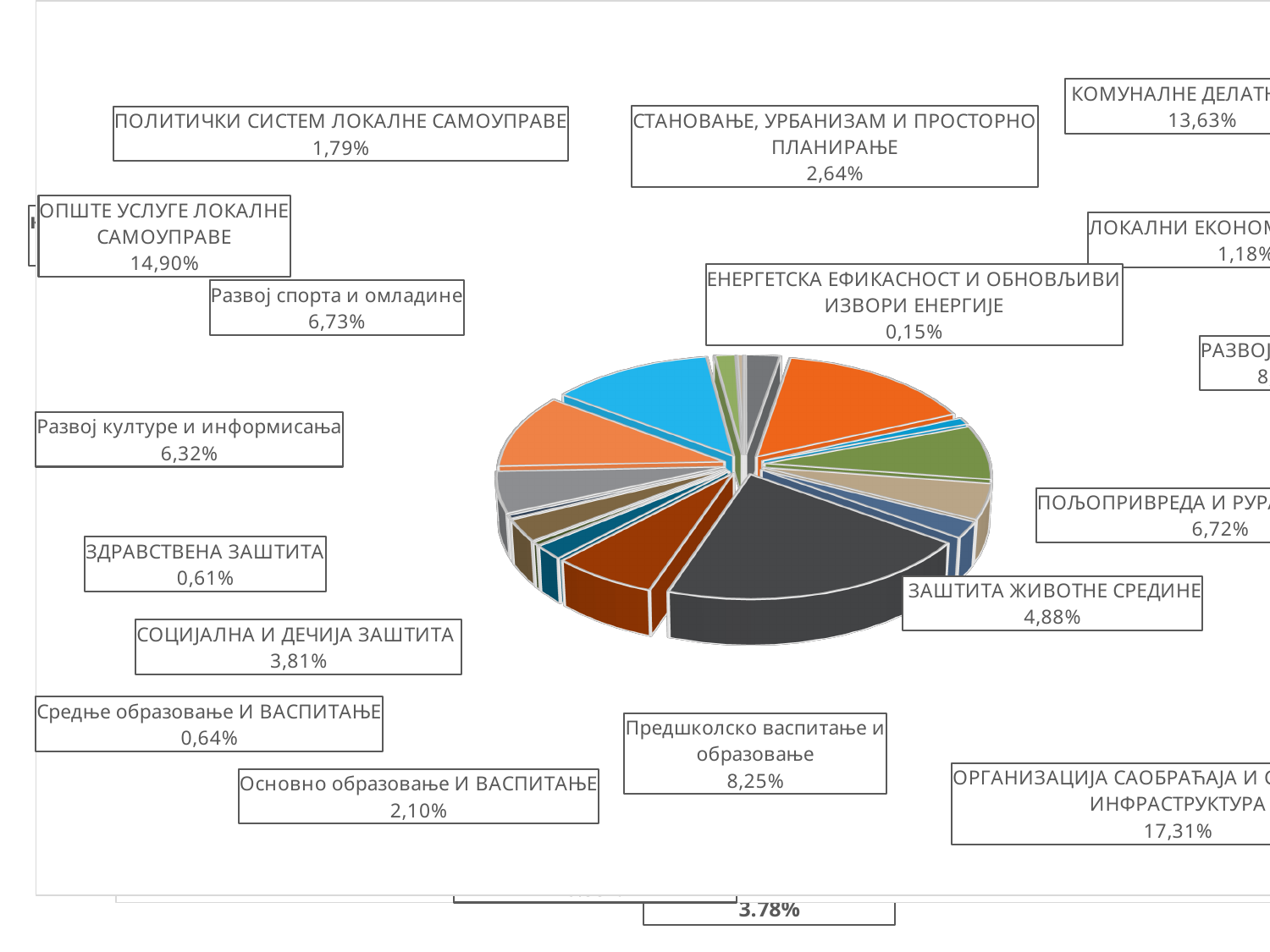
What type of chart is shown on the slide? pie chart What share does ОПШТЕ УСЛУГЕ ЛОКАЛНЕ САМОУПРАВЕ have in the pie chart? 14,90% What is the value for СОЦИЈАЛНА И ДЕЧИЈА ЗАШТИТА? 3,81% What share is shown for СТАНОВАЊЕ, УРБАНИЗАМ И ПРОСТОРНО ПЛАНИРАЊЕ? 2,64% Which is larger: Развој спорта и омладине or Развој културе и информисања? Развој спорта и омладине What is the value for ЗДРАВСТВЕНА ЗАШТИТА? 0,61% What is the value shown for ЗАШТИТА ЖИВОТНЕ СРЕДИНЕ? 4,88% What is the difference in percentage points between Предшколско васпитање и образовање (8,25%) and Основно образовање И ВАСПИТАЊЕ (2,10%)? 6,15 Which category has the smallest share in the pie chart? ЕНЕРГЕТСКА ЕФИКАСНОСТ И ОБНОВЉИВИ ИЗВОРИ ЕНЕРГИЈЕ What percentage is labelled for Предшколско васпитање и образовање? 8,25% What is the difference in percentage points between ОПШТЕ УСЛУГЕ ЛОКАЛНЕ САМОУПРАВЕ and ЗАШТИТА ЖИВОТНЕ СРЕДИНЕ? 10,02 Which is larger: ПОЛИТИЧКИ СИСТЕМ ЛОКАЛНЕ САМОУПРАВЕ or Основно образовање И ВАСПИТАЊЕ? Основно образовање И ВАСПИТАЊЕ